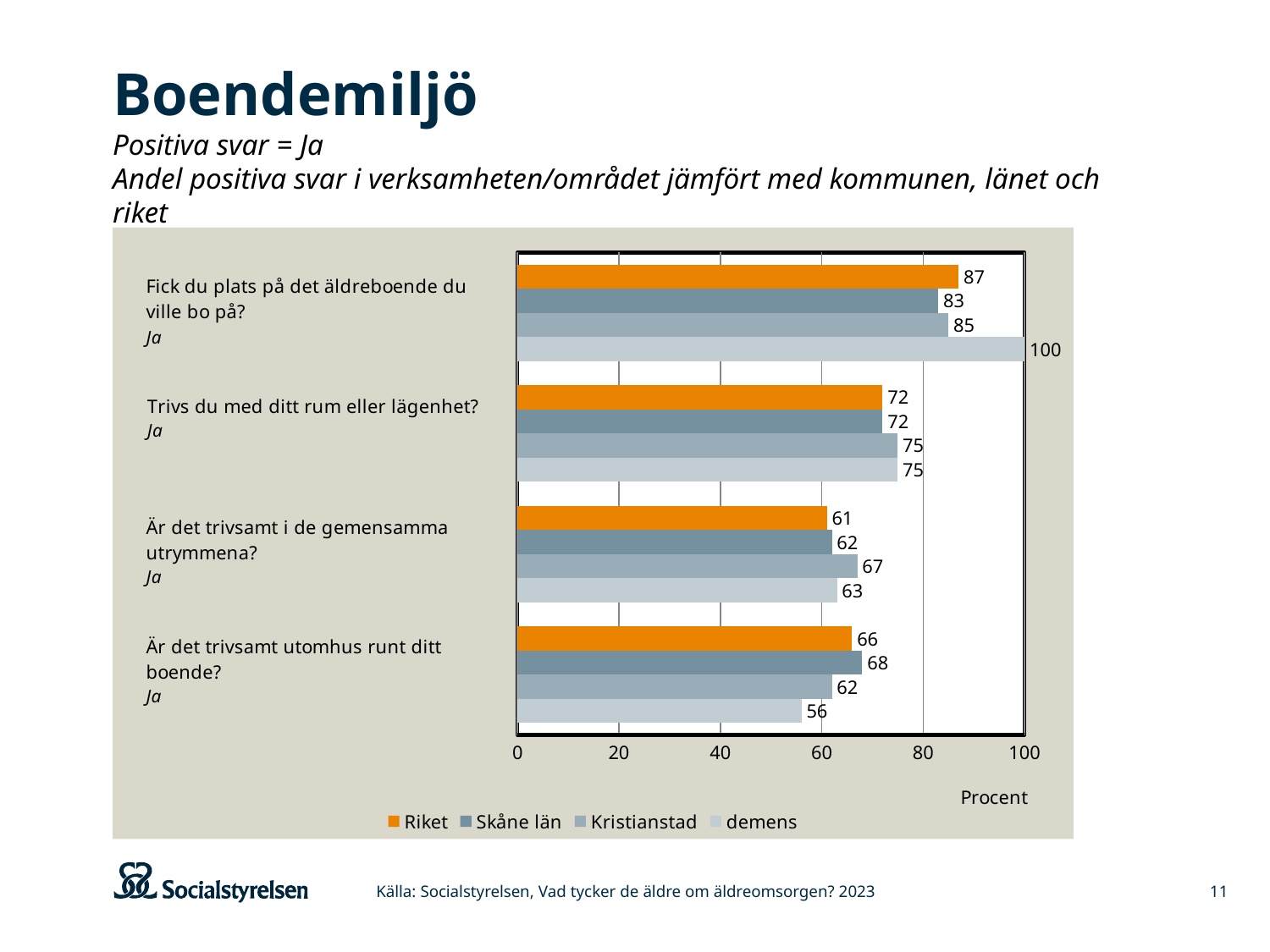
Which series has the highest value for "Fick du plats på det äldreboende du ville bo på?"? demens How many series does the legend list? 4 What kind of chart is shown on the slide? bar chart What is the value for Kristianstad for "Är det trivsamt i de gemensamma utrymmena?"? 67 How many question categories are plotted on the chart? 4 What is the difference between the Riket and Skåne län values for "Fick du plats på det äldreboende du ville bo på?"? 4 What unit label is shown below the x axis of the chart? Procent For "Är det trivsamt utomhus runt ditt boende?", which is larger: the value for Riket or the value for Kristianstad? Riket Which series has the lowest value for "Är det trivsamt utomhus runt ditt boende?"? demens What is the value for Riket for "Trivs du med ditt rum eller lägenhet?"? 72 What is the value for demens for "Fick du plats på det äldreboende du ville bo på?"? 100 What is the value for Skåne län for "Är det trivsamt utomhus runt ditt boende?"? 68